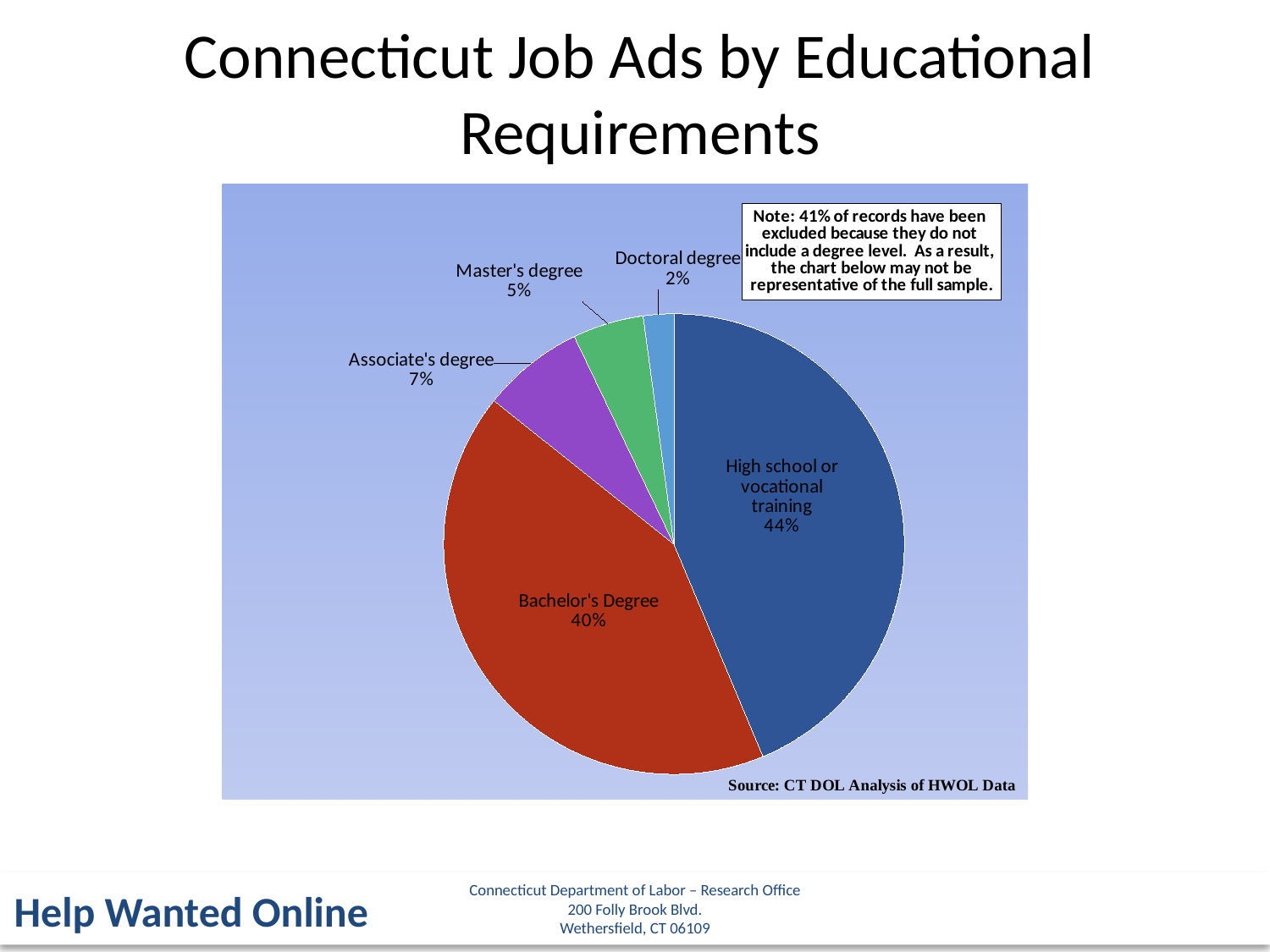
What share of Connecticut job ads require a Bachelor's Degree? 40% According to the note on the chart, what percentage of records were excluded because they do not include a degree level? 41% What percentage of job ads require a Master's degree? 5% How many percentage points larger is the High school or vocational training share than the Bachelor's Degree share? 4 percentage points Which is larger, the share for Associate's degree or the share for Master's degree? Associate's degree What kind of chart is shown on the slide? pie chart Which educational requirement has the smallest share of job ads? Doctoral degree Which educational requirement has the largest share of job ads? High school or vocational training What percentage of job ads require an Associate's degree? 7% What share of job ads require High school or vocational training? 44% How many slices does the pie chart have? 5 What percentage of job ads require a Doctoral degree? 2%